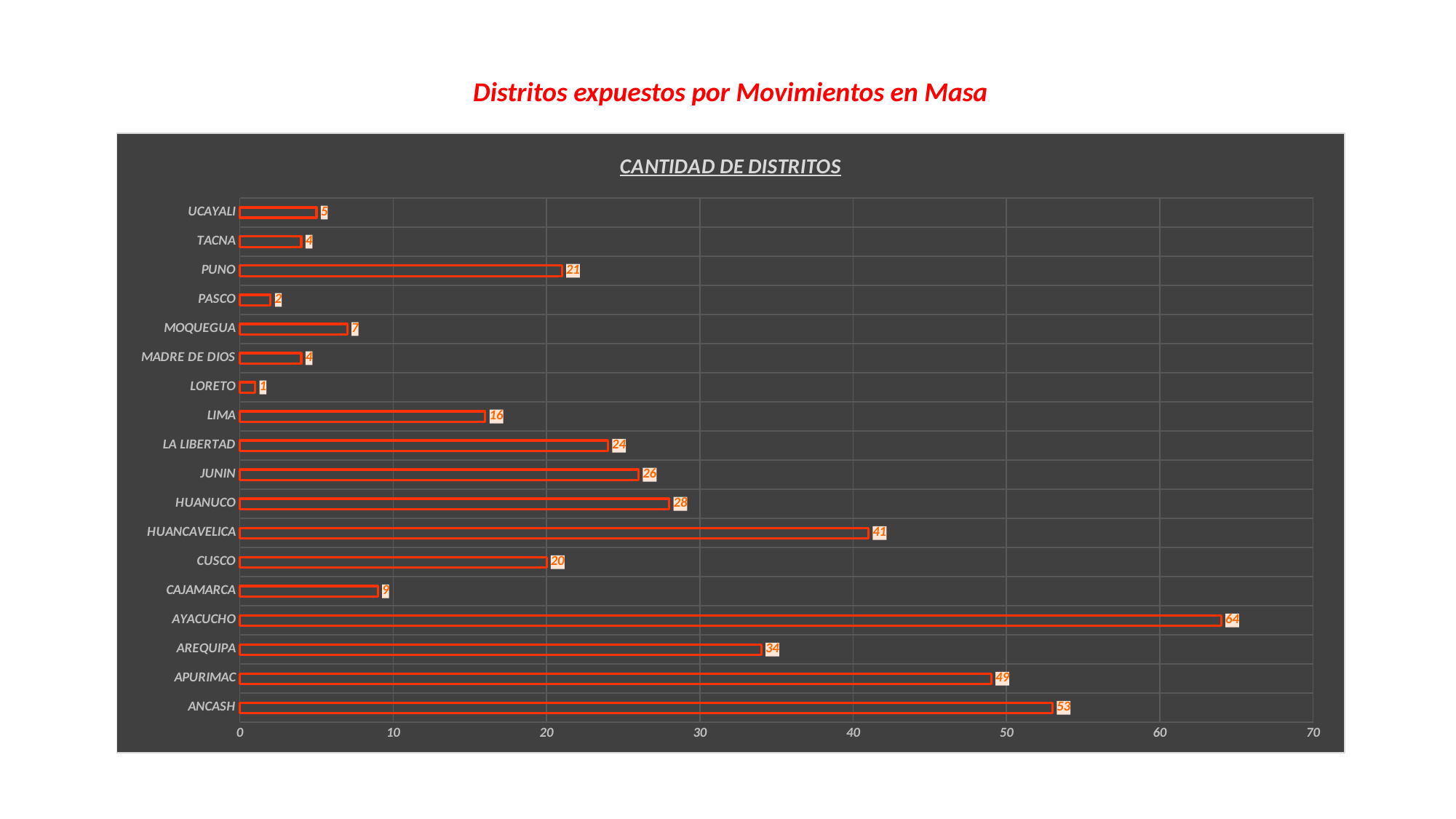
How many categories are shown on the chart? 18 What is the value for LIMA? 16 Is the value for AREQUIPA greater or less than 30? greater What is the difference between the values for ANCASH and APURIMAC? 4 What is the title of the chart? CANTIDAD DE DISTRITOS Which category has the lowest value? LORETO What kind of chart is shown on the slide? bar chart What is the value for HUANCAVELICA? 41 What is the value for AYACUCHO? 64 What is the difference between the values for PUNO and CUSCO? 1 Which category has the highest value? AYACUCHO Which is larger, the value for JUNIN or the value for LA LIBERTAD? JUNIN